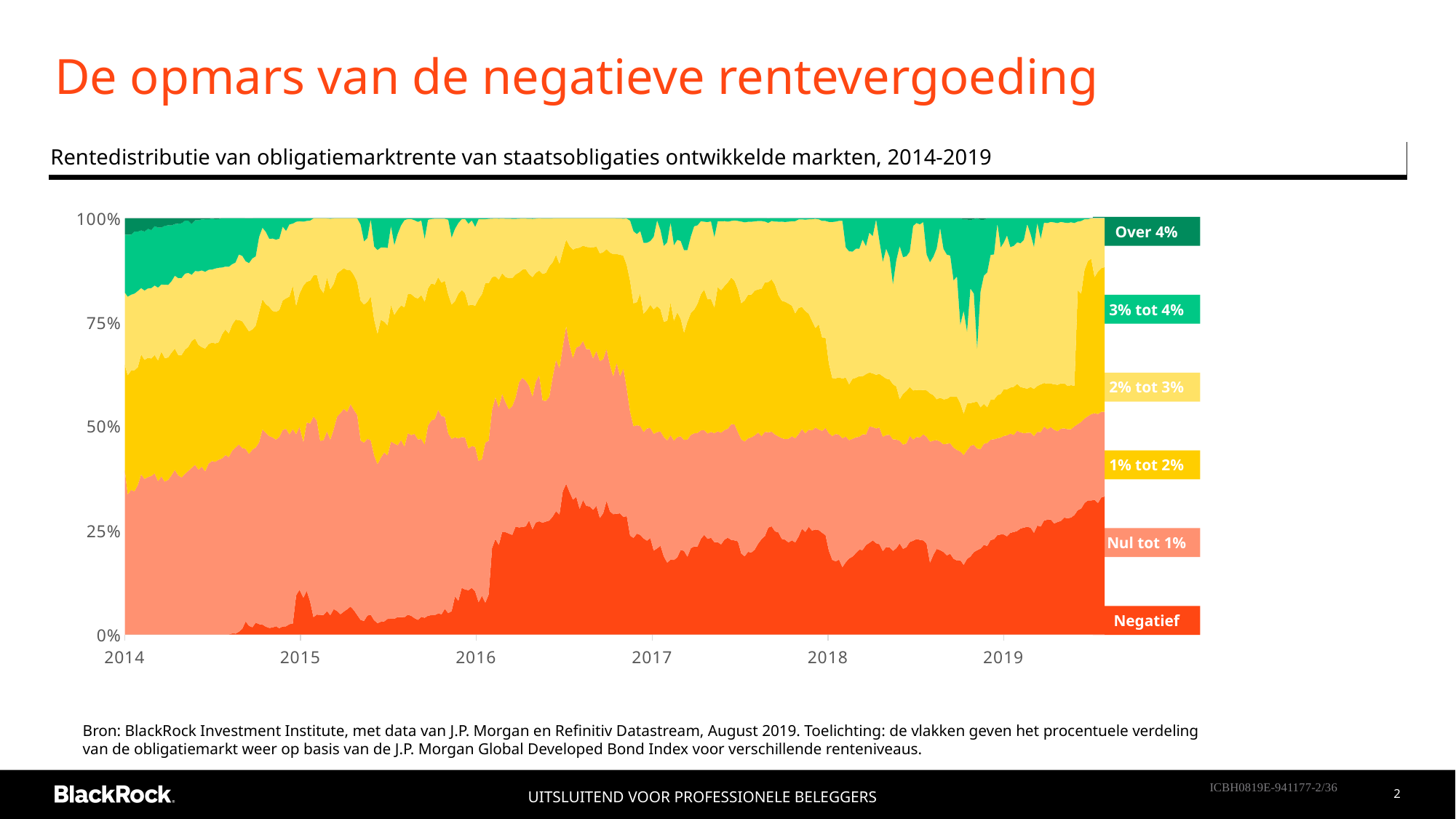
How many year labels are shown on the x axis? 6 How many series does the legend list? 6 Does the share of the Negatief category rise or fall from 2014 to 2019? Rises Does the share of the Over 4% category rise or fall from 2014 to 2019? Falls Which year is the last label on the x axis? 2019 Which year is the first label on the x axis? 2014 Is the share of the Negatief category at the end of the chart (2019) greater or less than 25%? greater Which legend entry is listed at the top of the legend? Over 4% Is the combined share of Negatief and Nul tot 1% at the end of the chart greater or less than 50%? greater What is the subtitle describing the chart? Rentedistributie van obligatiemarktrente van staatsobligaties ontwikkelde markten, 2014-2019 What kind of chart is shown on the slide? Stacked area chart Is the share of the Negatief category at the start of 2014 greater or less than 25%? less